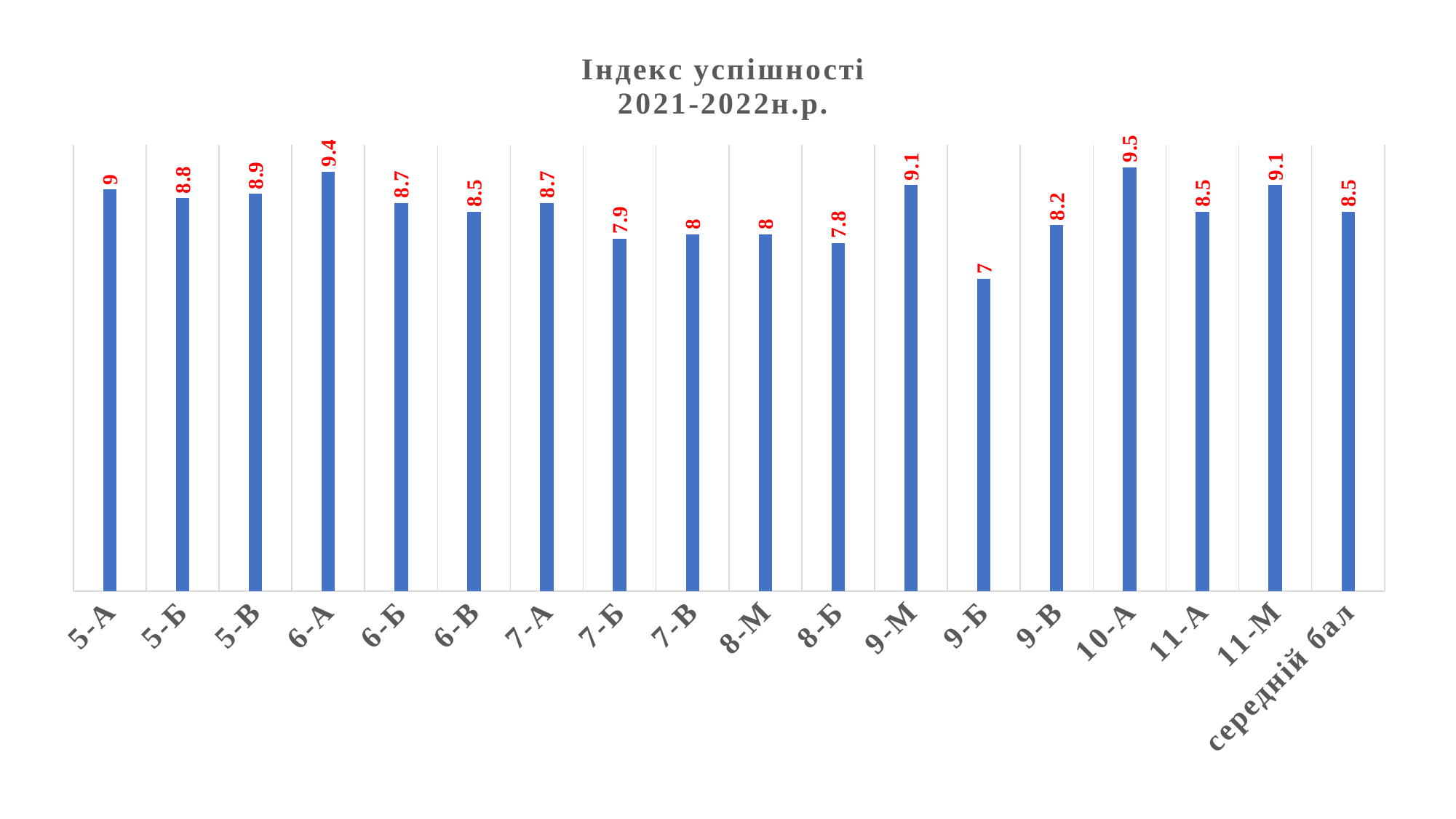
What is the title of the chart? Індекс успішності 2021-2022н.р. Which is larger, the value for 9-М or the value for 9-В? 9-М How many categories are shown on the x axis? 18 What is the difference between the values for 5-А and 8-Б? 1.2 What kind of chart is this? Bar chart What is the difference between the values for 10-А and 9-Б? 2.5 What is the value for 7-Б? 7.9 What is the value for середній бал? 8.5 What is the value for 9-Б? 7 What is the value for 6-А? 9.4 Which category has the highest value? 10-А Which category has the lowest value? 9-Б